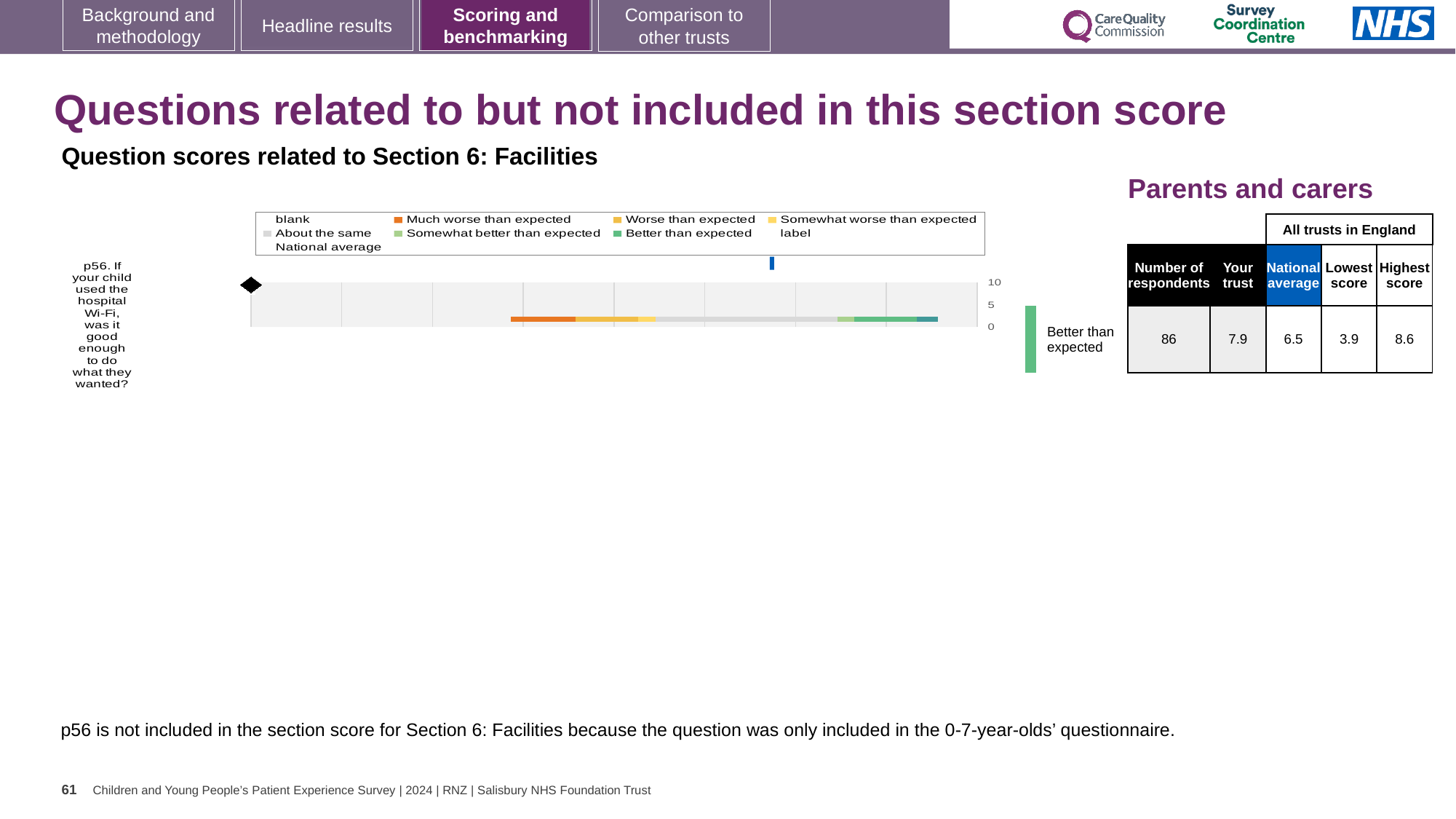
Which is larger for p56, the 'Your trust' score or the national average? Your trust How many respondents answered p56? 86 What is the lowest score among all trusts in England for p56? 3.9 What is the 'Your trust' score for p56 in the table next to the chart? 7.9 What is the highest score among all trusts in England for p56? 8.6 What type of chart is used to show the p56 question score? bar chart How many survey questions are plotted in the chart? 1 Which question number is plotted in the chart? p56 What is the national average score for p56? 6.5 What is the difference between the highest and lowest scores for p56? 4.7 What benchmark category label is shown beside the green marker to the right of the chart for p56? Better than expected What is the difference between the 'Your trust' score and the national average for p56? 1.4